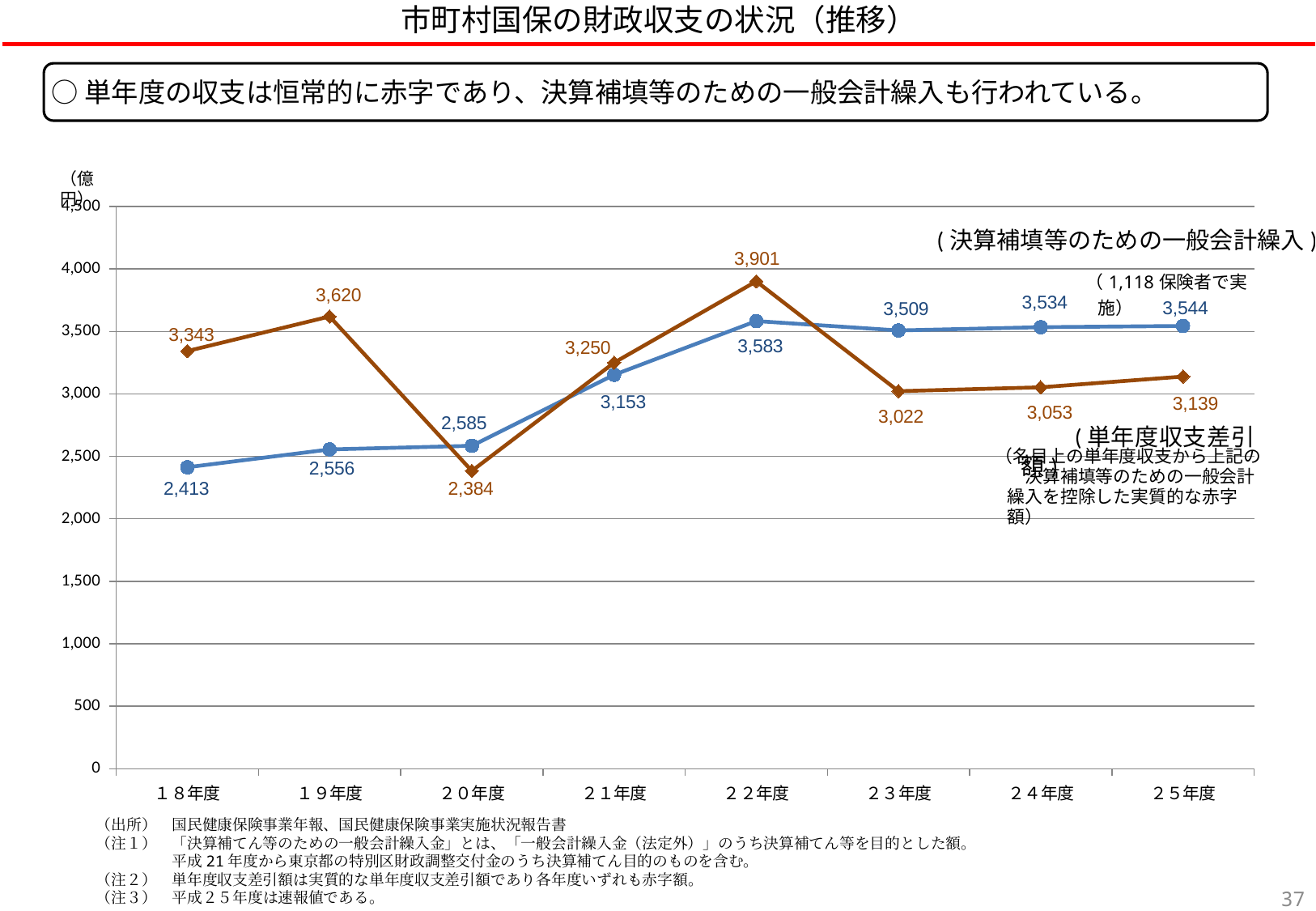
What unit is shown on the vertical axis of the chart? 億円 In which fiscal year is the blue line (決算補填等のための一般会計繰入) at its lowest value? １８年度 What type of chart is shown on the slide? line chart In which fiscal year does the brown line (単年度収支差引額) reach its highest value? ２２年度 How many fiscal years are plotted along the x axis? 8 What is the value of the blue line (決算補填等のための一般会計繰入) for １８年度? 2,413 In ２３年度, which is larger: the blue line (決算補填等のための一般会計繰入) or the brown line (単年度収支差引額)? the blue line (決算補填等のための一般会計繰入) Does the blue line (決算補填等のための一般会計繰入) rise or fall from １８年度 to ２２年度? rise What is the value of the blue line (決算補填等のための一般会計繰入) for ２５年度? 3,544 What is the value of the brown line (単年度収支差引額) for ２２年度? 3,901 What is the difference between the brown line value and the blue line value in １９年度? 1,064 What is the value of the brown line (単年度収支差引額) for ２０年度? 2,384